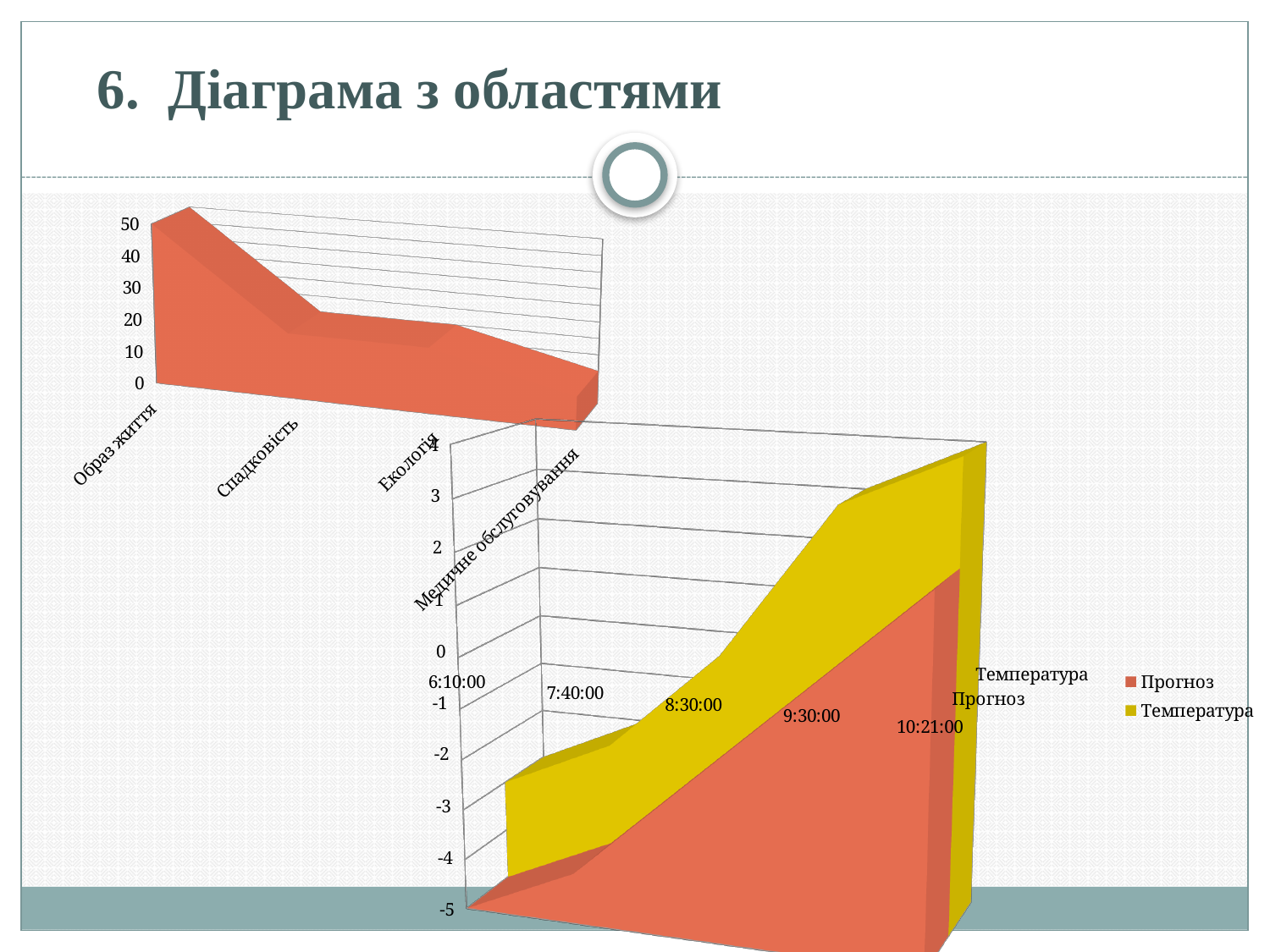
In the top-left chart, which category has the lowest value? Медичне обслуговування In the bottom-right chart, which series is shown in yellow? Температура In the top-left chart, which category has the highest value? Образ життя In the top-left chart, is the value for Спадковість greater or less than 30? less In the top-left chart, do the values rise or fall from Образ життя to Медичне обслуговування? fall In the bottom-right chart, how many time points are shown on the x axis? 5 In the top-left chart, how many categories are shown on the x axis? 4 In the bottom-right chart, how many series does the legend list? 2 What type of chart is the top-left chart on the slide? area chart In the top-left chart, is the value for Образ життя greater or less than 40? greater What type of chart is the bottom-right chart with the Прогноз and Температура series? area chart In the bottom-right chart, do the values of the Температура series rise or fall from 6:10:00 to 10:21:00? rise